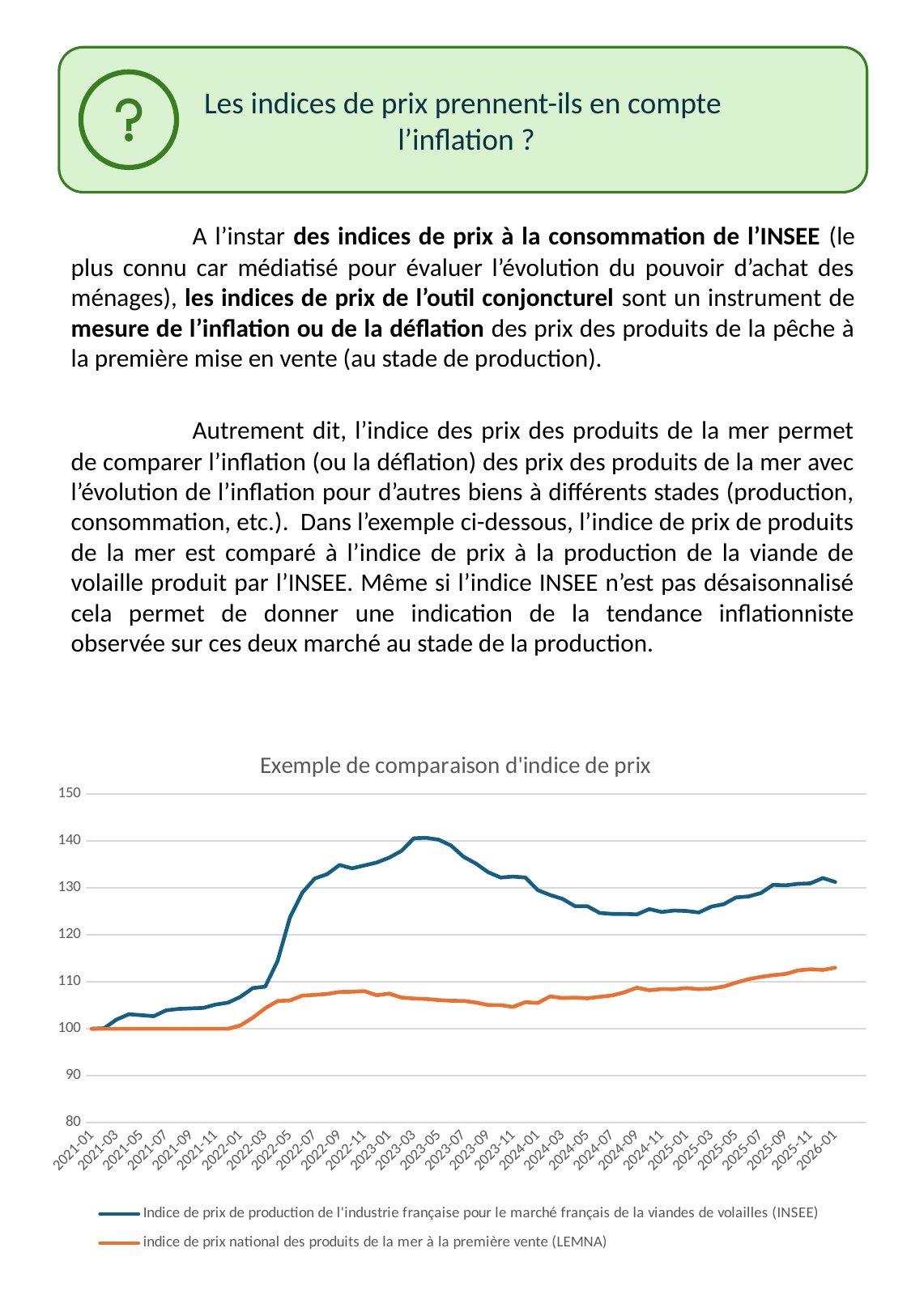
Is the value of the INSEE poultry meat price index at 2023-05 greater or less than 130? greater Which colour is used for the LEMNA seafood price index line? orange At 2023-05, which series has the higher value: the INSEE poultry meat index or the LEMNA seafood index? INSEE poultry meat index Is the value of the INSEE poultry meat price index at 2024-07 greater or less than 130? less Is the value of the LEMNA seafood price index at 2026-01 greater or less than 110? greater What is the title of the chart? Exemple de comparaison d'indice de prix What kind of chart is shown on the slide? line chart Does the LEMNA seafood price index rise or fall overall between 2021-01 and 2026-01? rise What is the value of the INSEE poultry meat price index at 2021-01? 100 How many series does the chart's legend list? 2 What is the value of the LEMNA seafood price index at 2021-01? 100